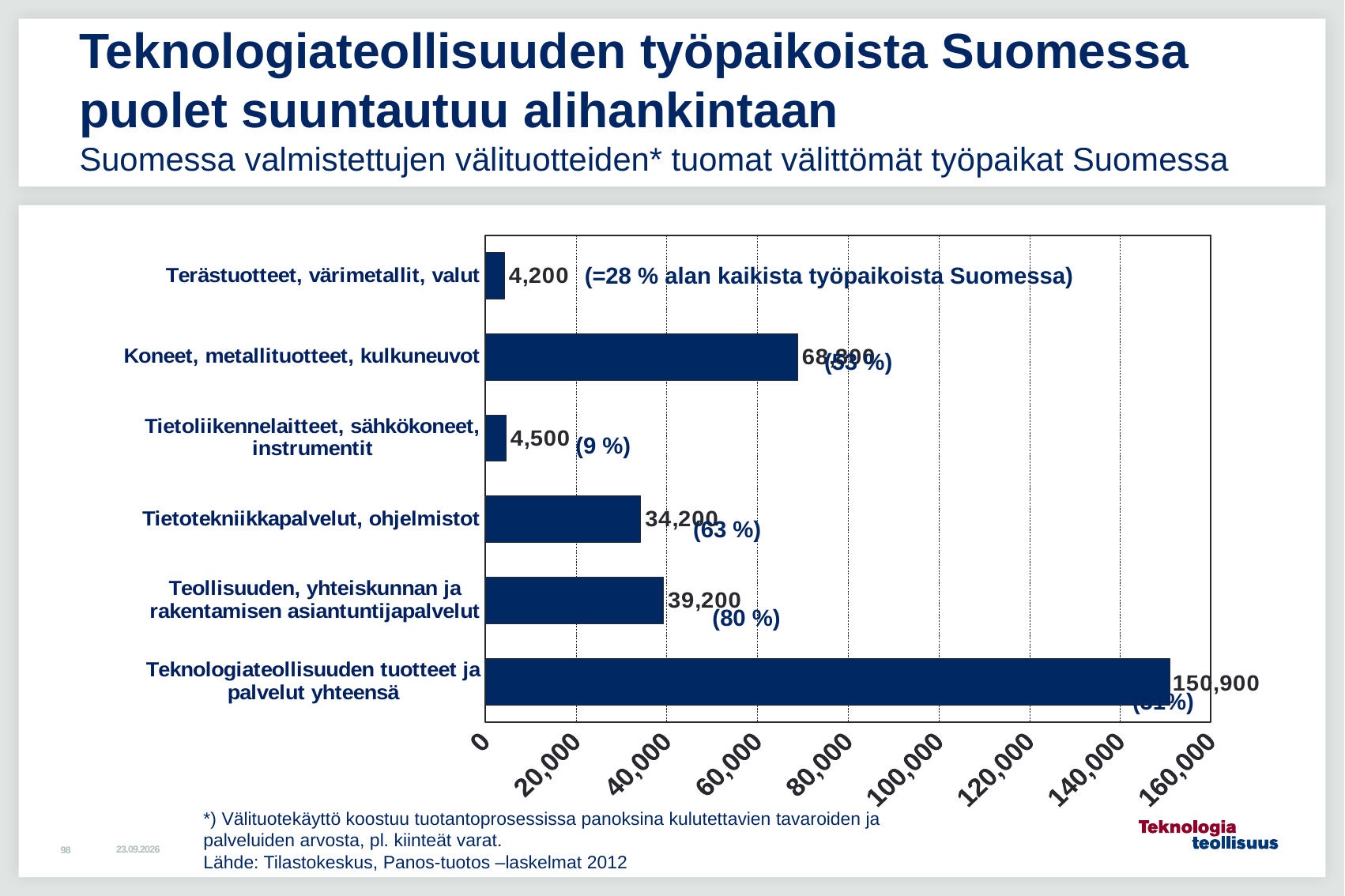
What is the value for Teollisuuden, yhteiskunnan ja rakentamisen asiantuntijapalvelut? 39,200 How many categories are shown in the chart? 6 Which category has the highest value? Teknologiateollisuuden tuotteet ja palvelut yhteensä Which category has the lowest value? Terästuotteet, värimetallit, valut What is the value for Tietoliikennelaitteet, sähkökoneet, instrumentit? 4,500 Is the value for Koneet, metallituotteet, kulkuneuvot greater or less than 60,000? greater What is the difference between the values for Teollisuuden, yhteiskunnan ja rakentamisen asiantuntijapalvelut and Tietotekniikkapalvelut, ohjelmistot? 5,000 What kind of chart is shown on the slide? bar chart What is the value for Teknologiateollisuuden tuotteet ja palvelut yhteensä? 150,900 What is the value for Tietotekniikkapalvelut, ohjelmistot? 34,200 Which is larger: Tietotekniikkapalvelut, ohjelmistot or Teollisuuden, yhteiskunnan ja rakentamisen asiantuntijapalvelut? Teollisuuden, yhteiskunnan ja rakentamisen asiantuntijapalvelut What is the value for Terästuotteet, värimetallit, valut? 4,200